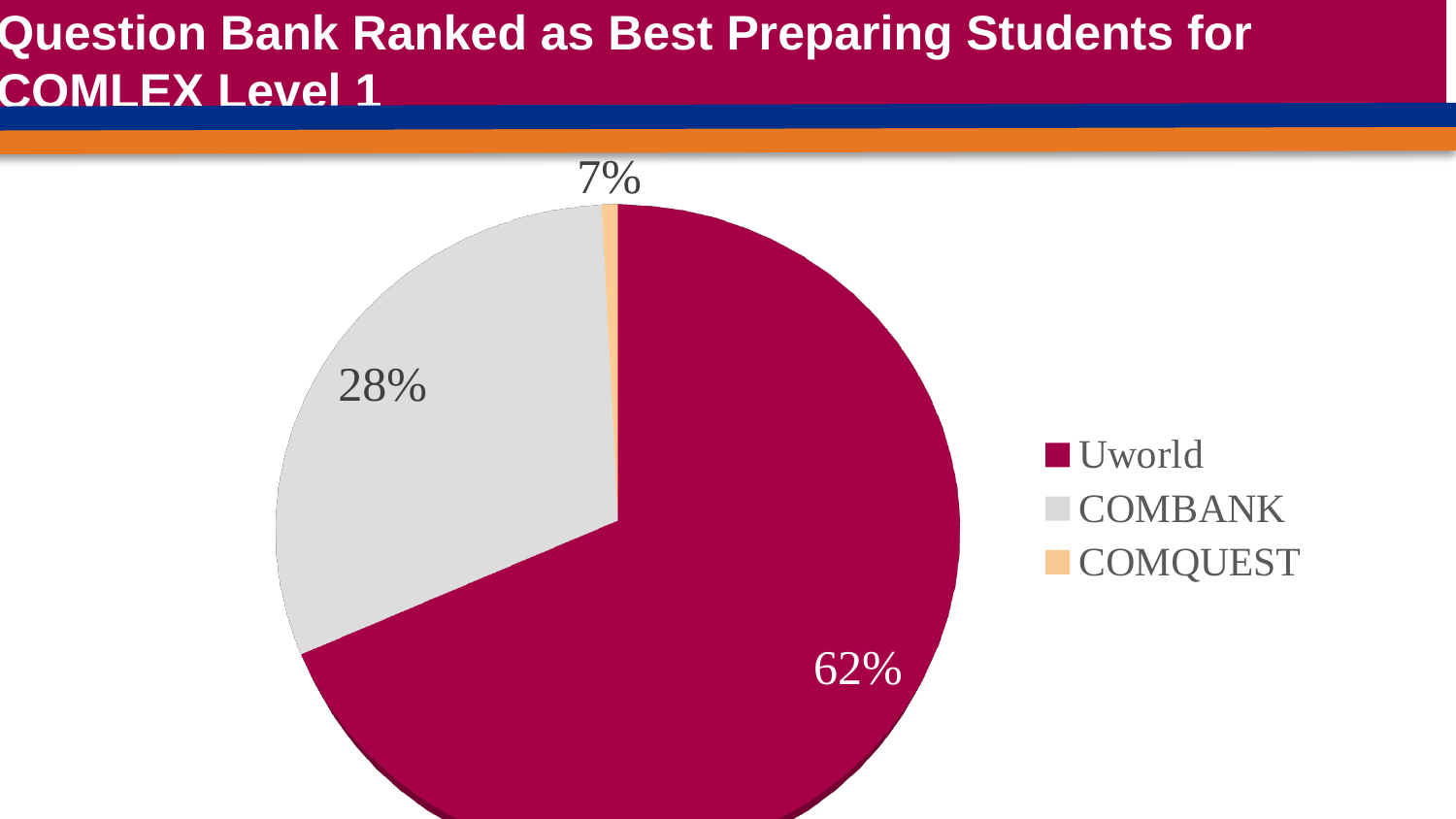
How many slices does the pie chart have? 3 What percentage of the pie is Uworld? 62% What is the title of the chart? Question Bank Ranked as Best Preparing Students for COMLEX Level 1 How many entries does the legend list? 3 Which question bank has the largest share of the pie? Uworld Which has a larger share, Uworld or COMBANK? Uworld What is the difference in percentage points between Uworld and COMBANK? 34 What kind of chart is shown on the slide? pie chart What percentage of the pie is COMBANK? 28% What percentage of the pie is COMQUEST? 7% Which question bank is shown in the grey slice? COMBANK Which question bank has the smallest share of the pie? COMQUEST